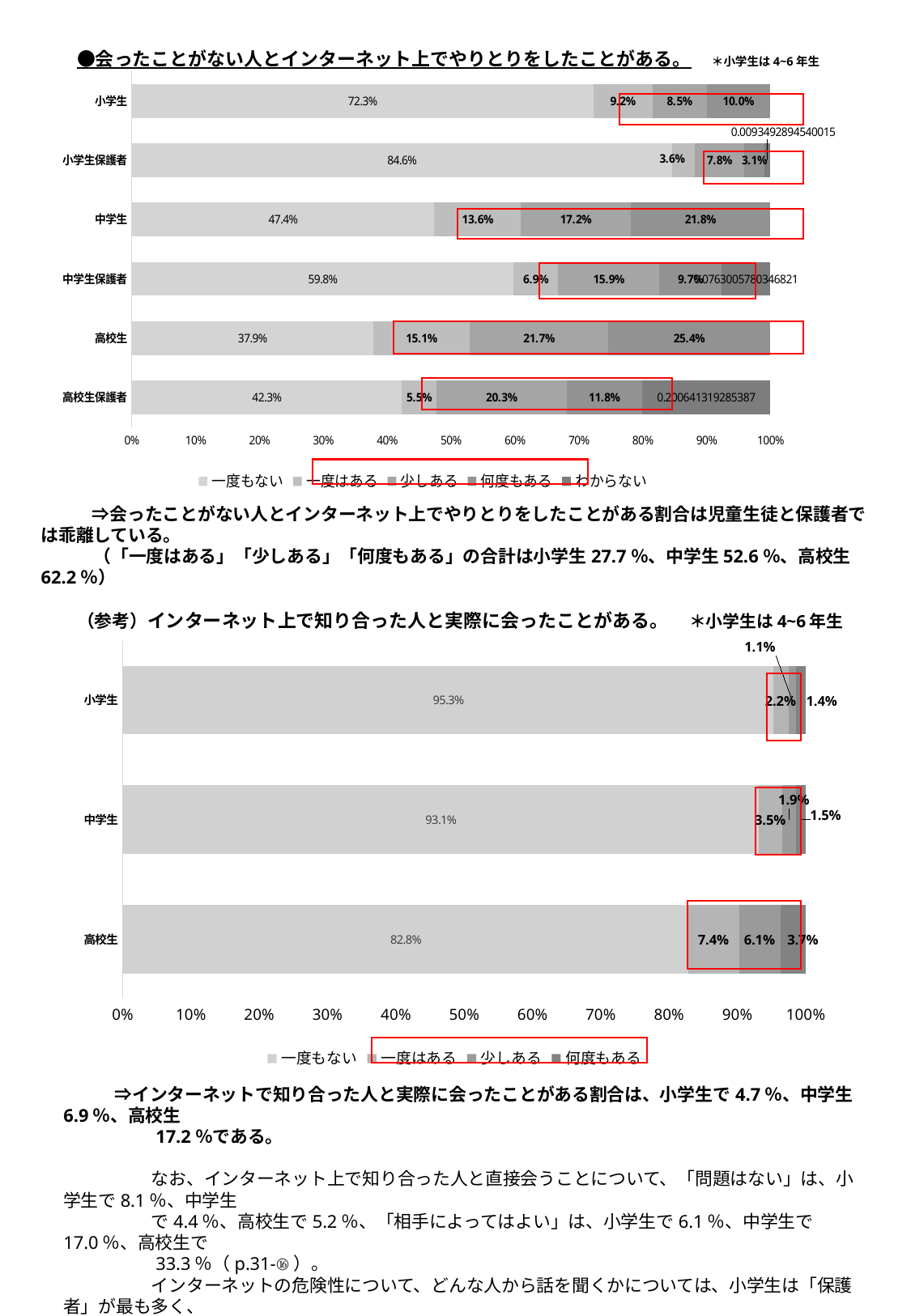
In the top chart (会ったことがない人とインターネット上でやりとりをしたことがある), which category has the highest value for 一度もない? 小学生保護者 How many categories are shown in the top chart (会ったことがない人とインターネット上でやりとりをしたことがある)? 6 In the bottom chart (インターネット上で知り合った人と実際に会ったことがある), what is the value of 一度もない for 高校生? 82.8% How many series does the legend of the top chart (会ったことがない人とインターネット上でやりとりをしたことがある) list? 5 In the bottom chart (インターネット上で知り合った人と実際に会ったことがある), what is the value of 一度はある for 中学生? 3.5% In the top chart (会ったことがない人とインターネット上でやりとりをしたことがある), what is the value of 何度もある for 高校生? 25.4% What kind of chart is the bottom chart (インターネット上で知り合った人と実際に会ったことがある)? bar chart In the top chart (会ったことがない人とインターネット上でやりとりをしたことがある), what is the difference between the 一度もない values for 小学生 and 高校生? 34.4 percentage points In the top chart (会ったことがない人とインターネット上でやりとりをしたことがある), what is the value of 一度もない for 中学生? 47.4% In the bottom chart (インターネット上で知り合った人と実際に会ったことがある), does the 一度もない value rise or fall going from 小学生 to 高校生? fall In the top chart (会ったことがない人とインターネット上でやりとりをしたことがある), which is larger for 少しある: 中学生 or 高校生保護者? 高校生保護者 In the top chart (会ったことがない人とインターネット上でやりとりをしたことがある), which category has the lowest value for 一度もない? 高校生